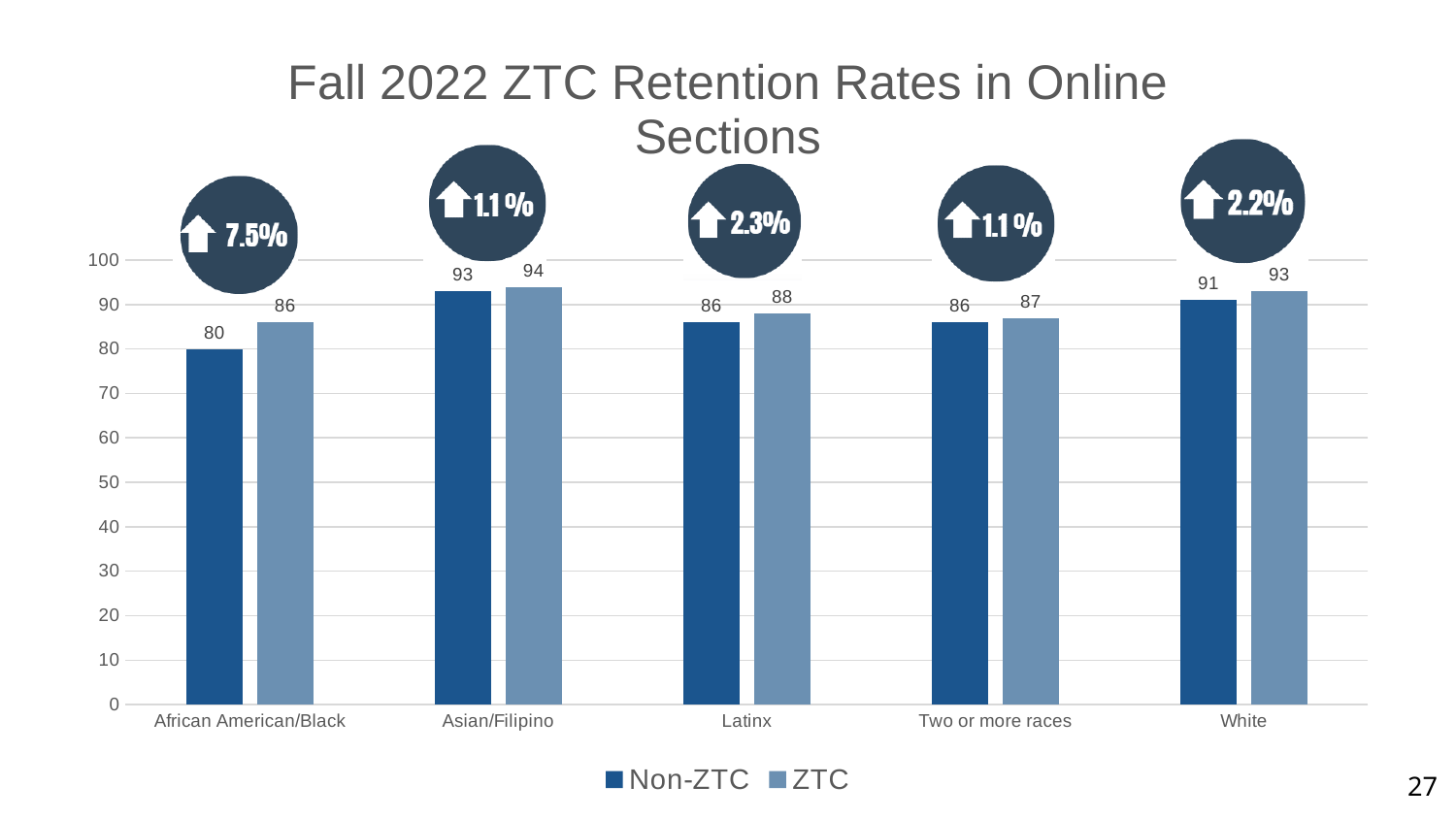
What is the Non-ZTC retention rate for White students? 91 What is the Non-ZTC retention rate for African American/Black students? 80 Which category has the lowest Non-ZTC retention rate? African American/Black Which category has the highest ZTC retention rate? Asian/Filipino What is the difference between the ZTC and Non-ZTC retention rates for African American/Black students? 6 What kind of chart is shown on the slide? Bar chart How many categories are shown on the x axis? 5 What is the ZTC retention rate for Asian/Filipino students? 94 What is the title of the chart? Fall 2022 ZTC Retention Rates in Online Sections What is the ZTC retention rate for Latinx students? 88 How many series does the legend list? 2 Which is larger for Two or more races: the ZTC or the Non-ZTC retention rate? ZTC